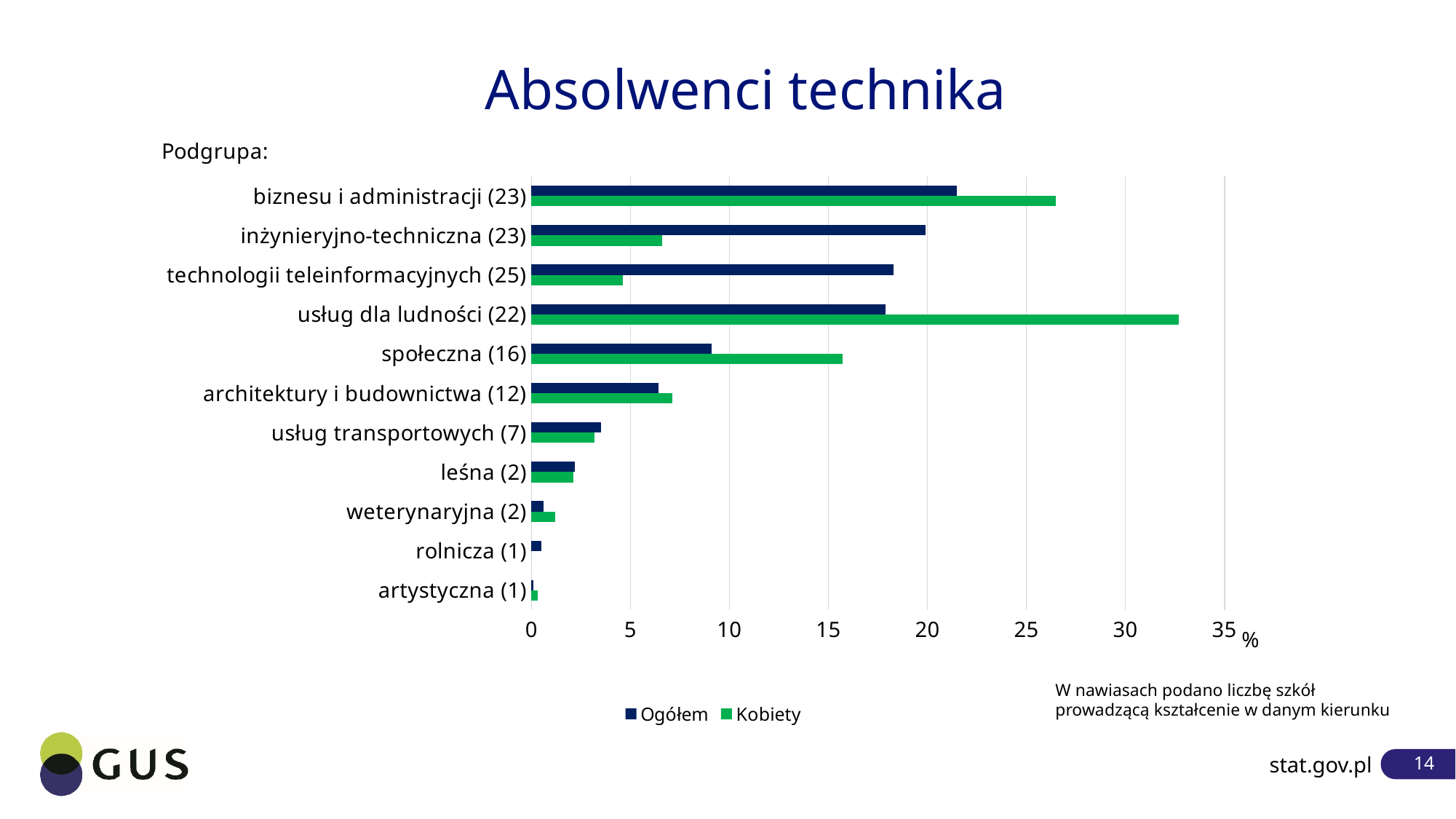
Which category has the highest value for the Ogółem series? biznesu i administracji (23) Is the Kobiety value for inżynieryjno-techniczna (23) greater or less than 10? less Is the Kobiety value for usług dla ludności (22) greater or less than 30? greater How many subgroup categories are plotted on the chart? 11 Is the Ogółem value for biznesu i administracji (23) greater or less than 20? greater Which category has the highest value for the Kobiety series? usług dla ludności (22) How many series does the legend list? 2 For usług dla ludności (22), which series has the larger value, Ogółem or Kobiety? Kobiety What kind of chart is shown on the slide? bar chart Which category has the lowest value for the Ogółem series? artystyczna (1) What is the title of the chart? Absolwenci technika For inżynieryjno-techniczna (23), which series has the larger value, Ogółem or Kobiety? Ogółem